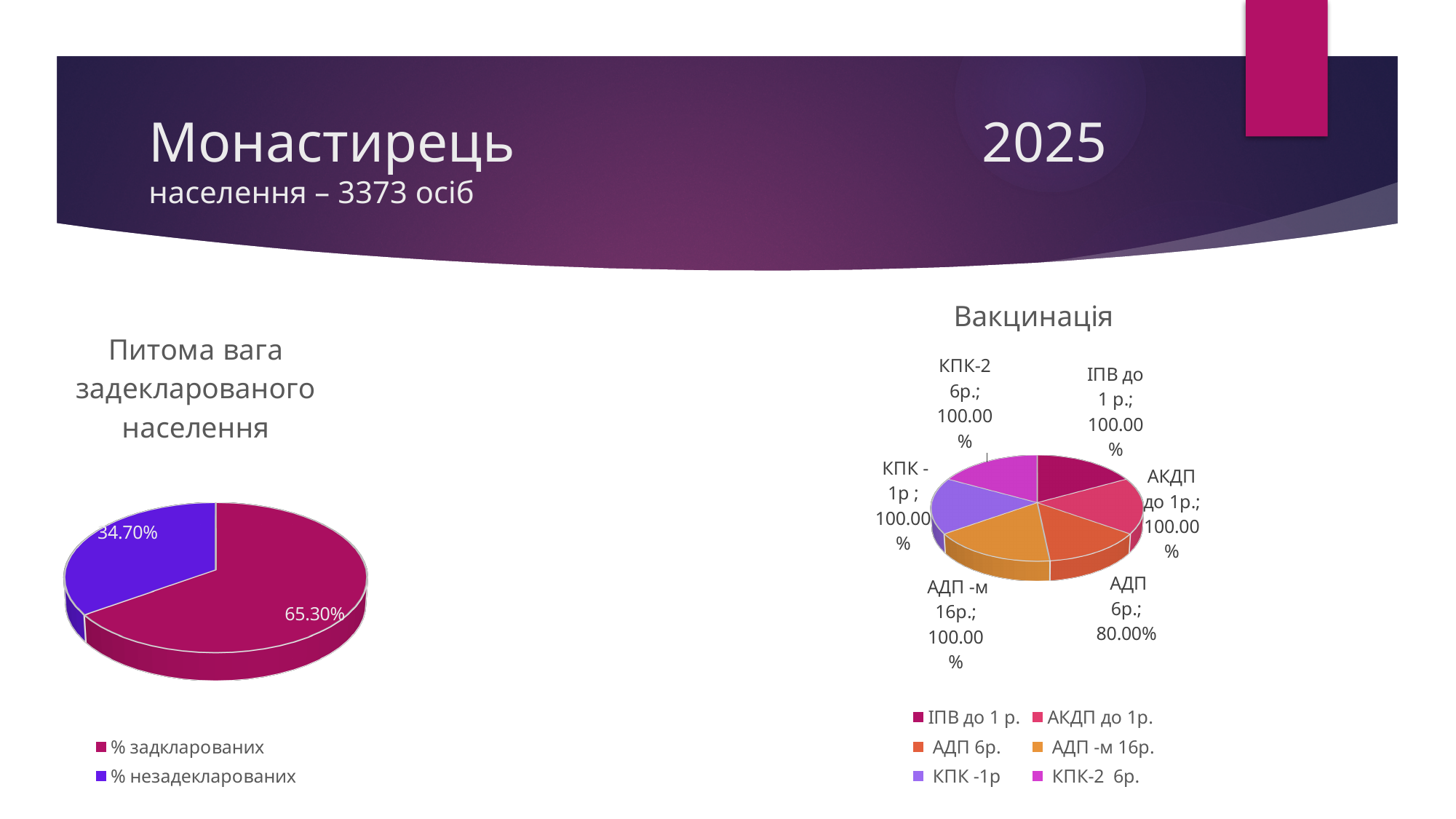
In the chart titled "Вакцинація", how many categories are shown? 6 What kind of chart is the chart titled "Вакцинація"? Pie chart In the chart titled "Вакцинація", what is the difference between the value for "АКДП до 1р." and the value for "АДП 6р."? 20.00% In the chart titled "Питома вага задекларованого населення", what is the value for "% задклaрованих"? 65.30% In the chart titled "Вакцинація", which is larger: the value for "КПК -1р" or the value for "АДП 6р."? КПК -1р In the chart titled "Питома вага задекларованого населення", which category has the larger share? % задклaрованих In the chart titled "Питома вага задекларованого населення", what is the difference between the two slices? 30.60% In the chart titled "Вакцинація", which category has the lowest value? АДП 6р. In the chart titled "Вакцинація", what is the value for "АДП 6р."? 80.00% In the chart titled "Питома вага задекларованого населення", how many series does the legend list? 2 In the chart titled "Питома вага задекларованого населення", what is the value for "% незадекларованих"? 34.70% In the chart titled "Вакцинація", what is the value for "ІПВ до 1 р."? 100.00%